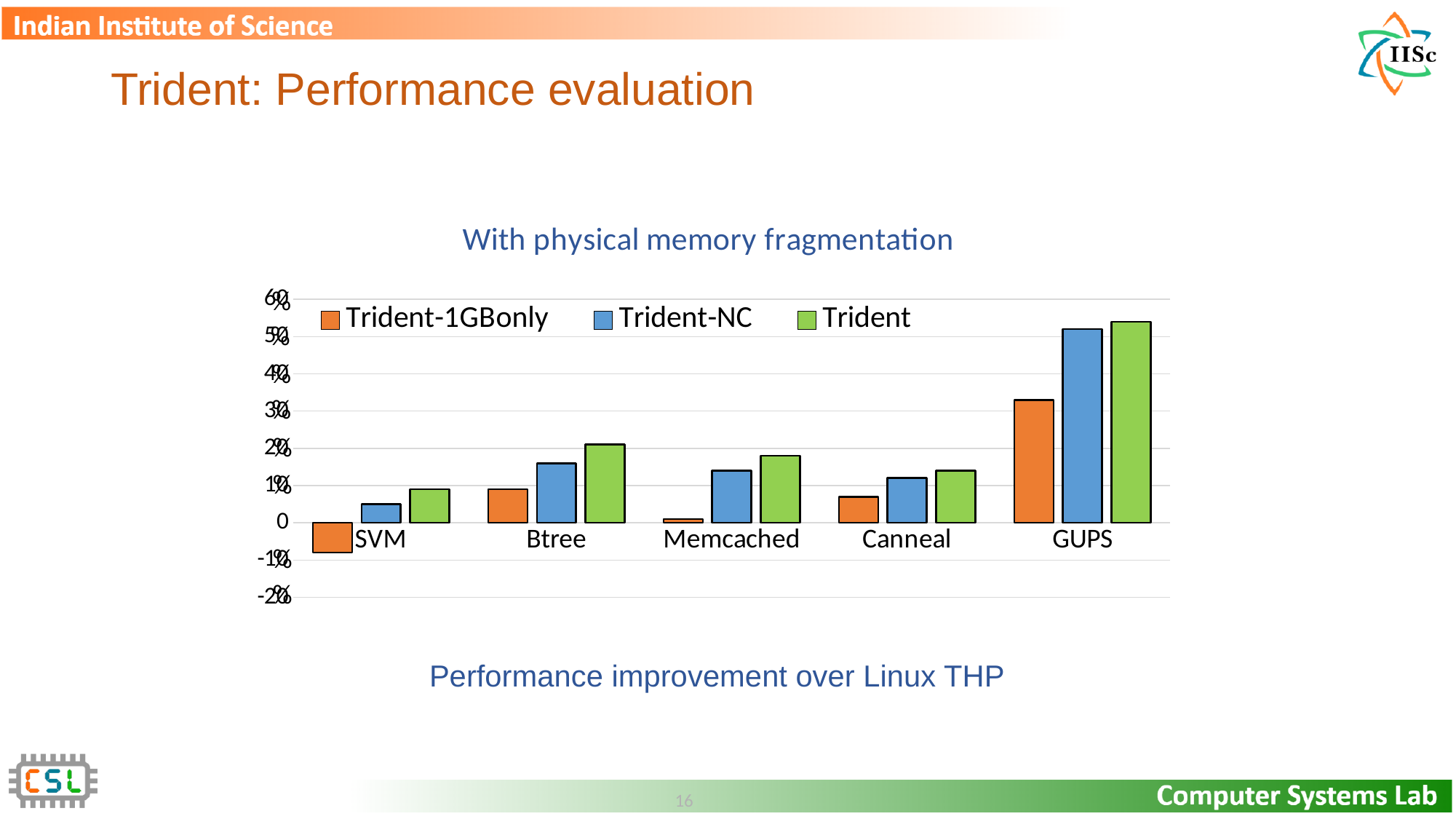
Is the value for Trident-1GBonly on SVM greater or less than 0? less What kind of chart is shown on the slide? bar chart Which category has the lowest value for the Trident-1GBonly series? SVM Which category has the highest value for the Trident series? GUPS For the Trident series, which is larger: Btree or Memcached? Btree What is the title of the chart? With physical memory fragmentation Which series is shown in orange in the chart? Trident-1GBonly For Memcached, which is larger: Trident-NC or Trident-1GBonly? Trident-NC Which category has the highest value for the Trident-NC series? GUPS Which series has the lowest value in the GUPS category? Trident-1GBonly How many categories are shown on the x axis of the chart? 5 How many series does the chart legend list? 3